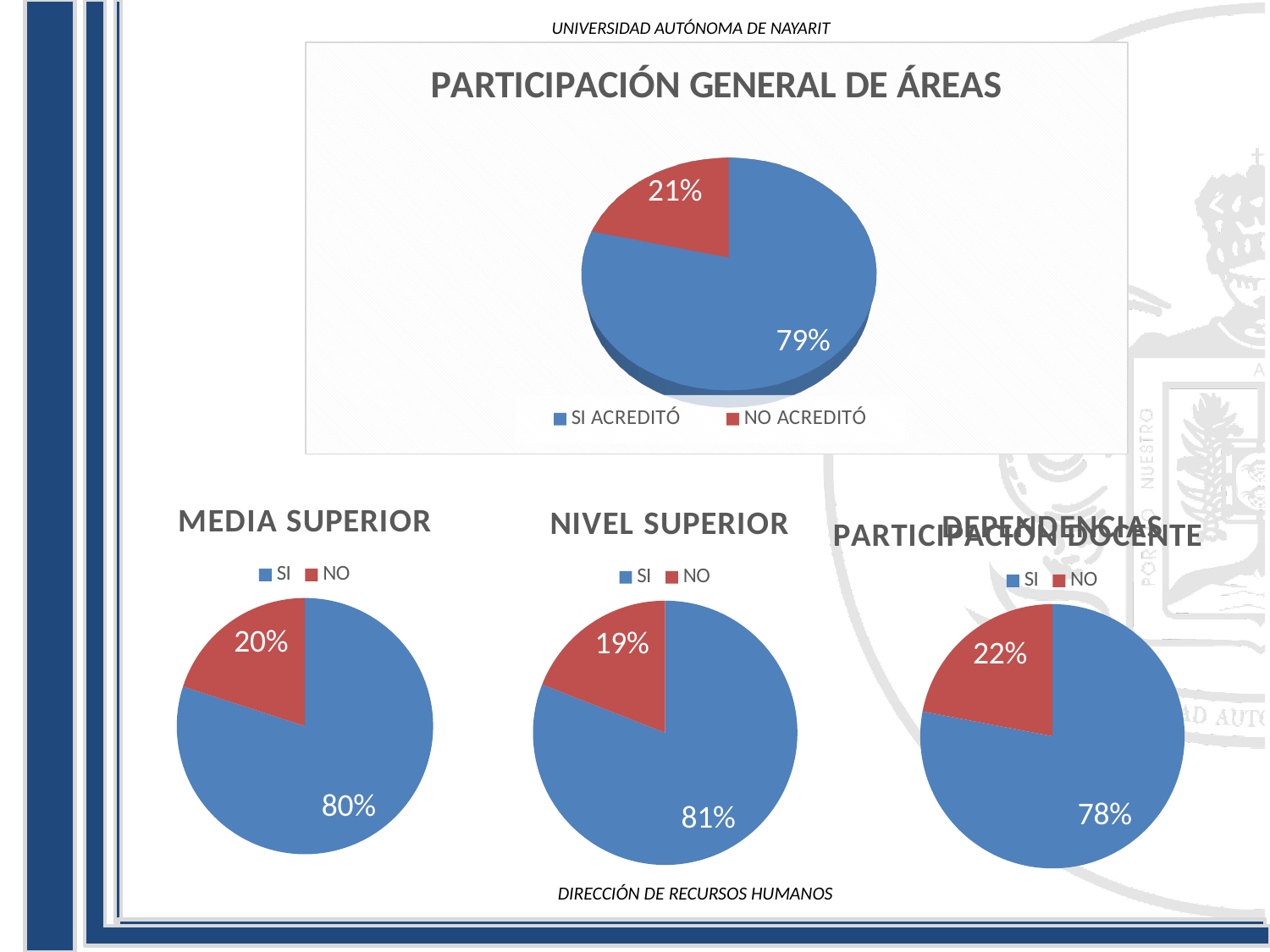
In the bottom-right pie chart, what share of the pie is NO? 22% In the NIVEL SUPERIOR chart, what share of the pie is NO? 19% In the MEDIA SUPERIOR chart, what share of the pie is NO? 20% In the MEDIA SUPERIOR chart, which slice is larger, SI or NO? SI In the NIVEL SUPERIOR chart, what is the difference between the SI and NO shares? 62% How many entries does the legend of the PARTICIPACIÓN GENERAL DE ÁREAS chart list? 2 What kind of chart is the PARTICIPACIÓN GENERAL DE ÁREAS chart? Pie chart